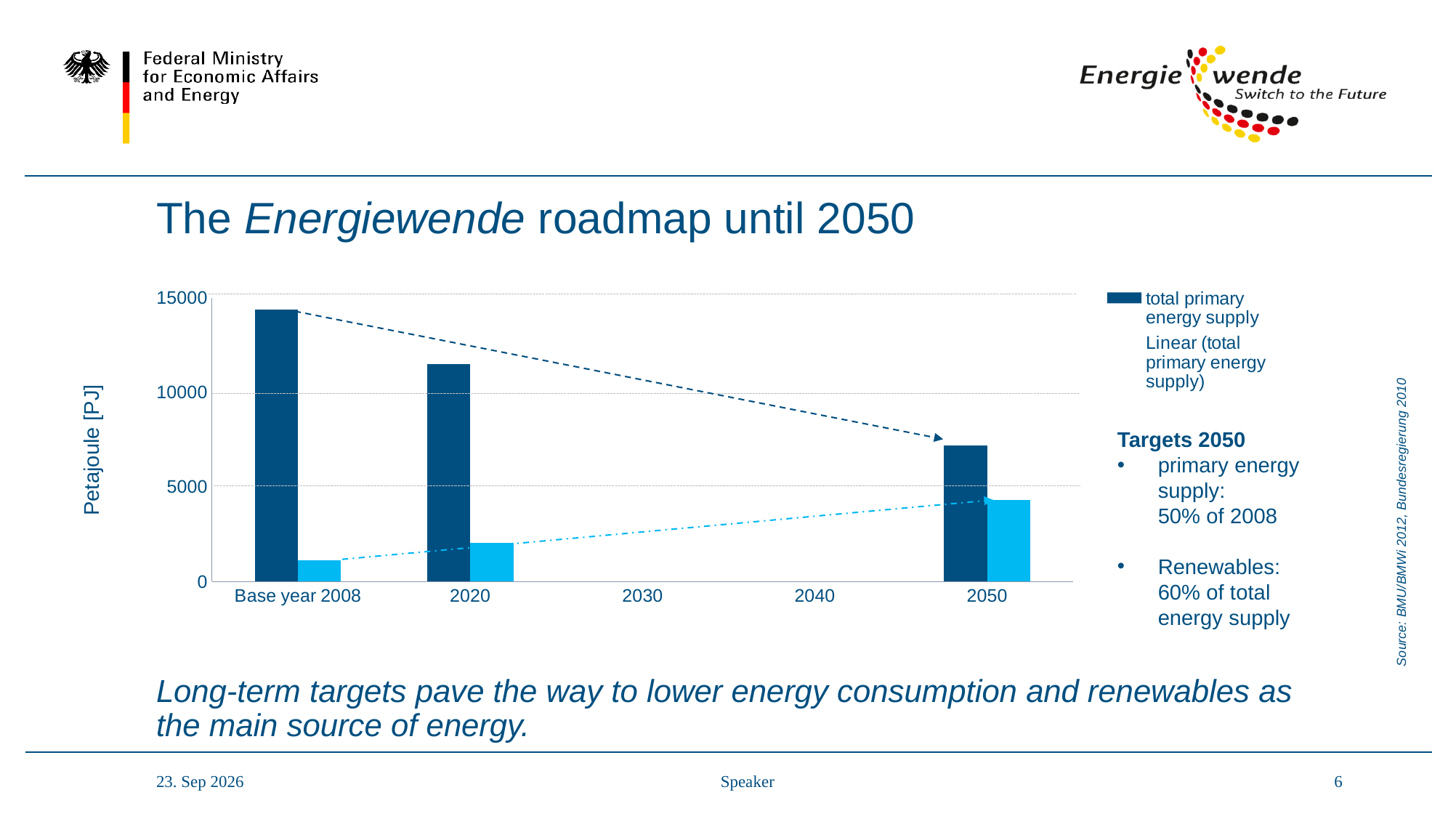
Is the total primary energy supply for 2050 greater or less than 5000? greater Is the total primary energy supply for Base year 2008 greater or less than 10000? greater Which is larger, the total primary energy supply in 2020 or in 2050? 2020 Is the total primary energy supply for 2050 greater or less than 10000? less In which year is the total primary energy supply bar lowest? 2050 What is the label of the y axis? Petajoule [PJ] What kind of chart is shown on the slide? bar chart In which year is the total primary energy supply bar highest? Base year 2008 How many categories are labelled on the x axis? 5 How many entries does the legend list? 2 Does the total primary energy supply rise or fall from Base year 2008 to 2050? fall